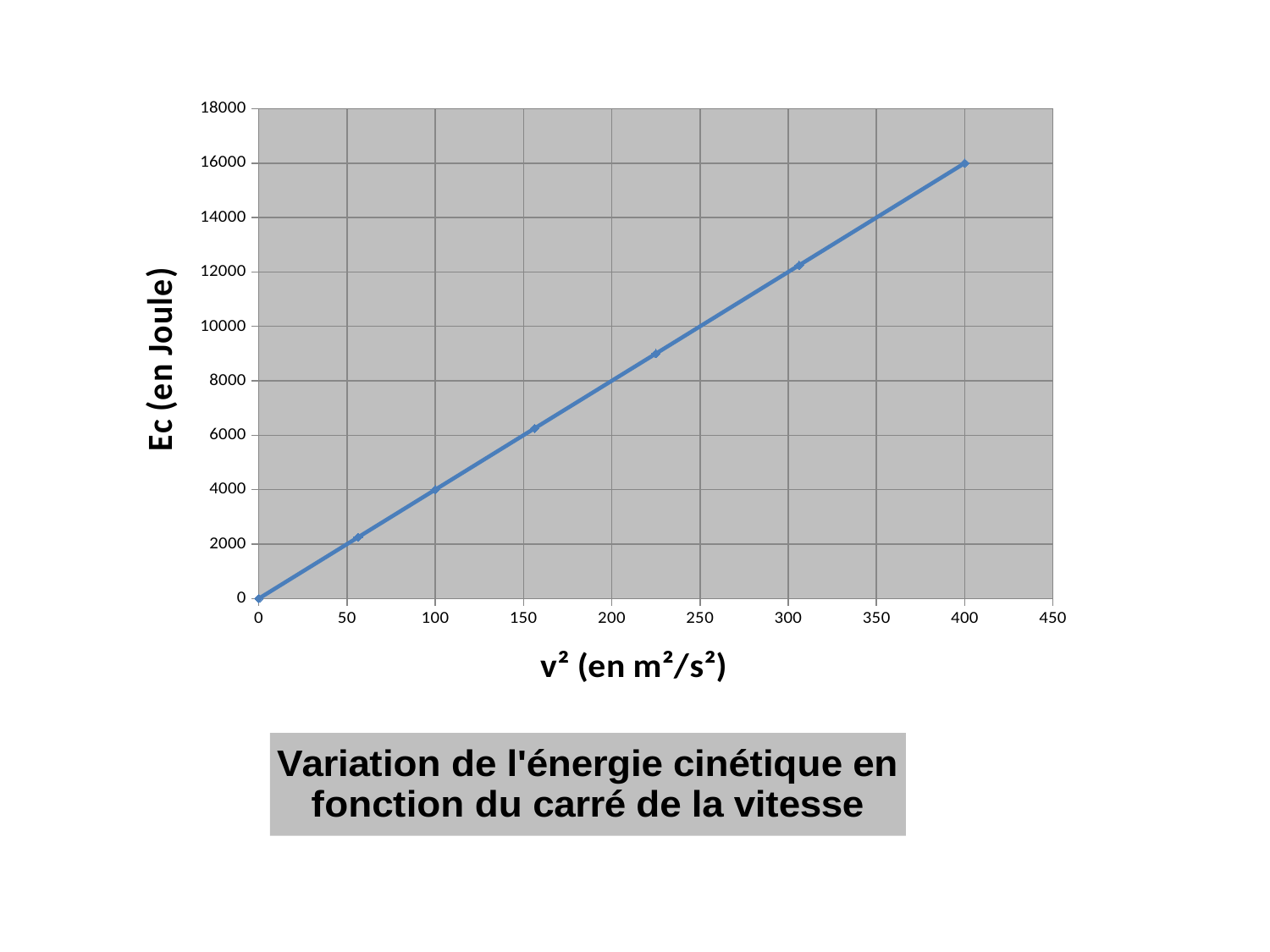
What is the title shown below the chart? Variation de l'énergie cinétique en fonction du carré de la vitesse How many data points are plotted on the chart? 7 What is the value of Ec when v² is 100 m²/s²? 4000 Is the value of Ec at v² = 225 greater or less than 8000? greater What is the label of the y axis? Ec (en Joule) Is the value of Ec at v² ≈ 306 greater or less than 14000? less At which v² value is Ec highest? 400 What is the value of Ec when v² is 400 m²/s²? 16000 Does Ec rise or fall as v² increases along the x axis? rises What kind of chart is shown on the slide? line chart Is the value of Ec at v² ≈ 56 greater or less than 4000? less What is the value of Ec when v² is 0? 0